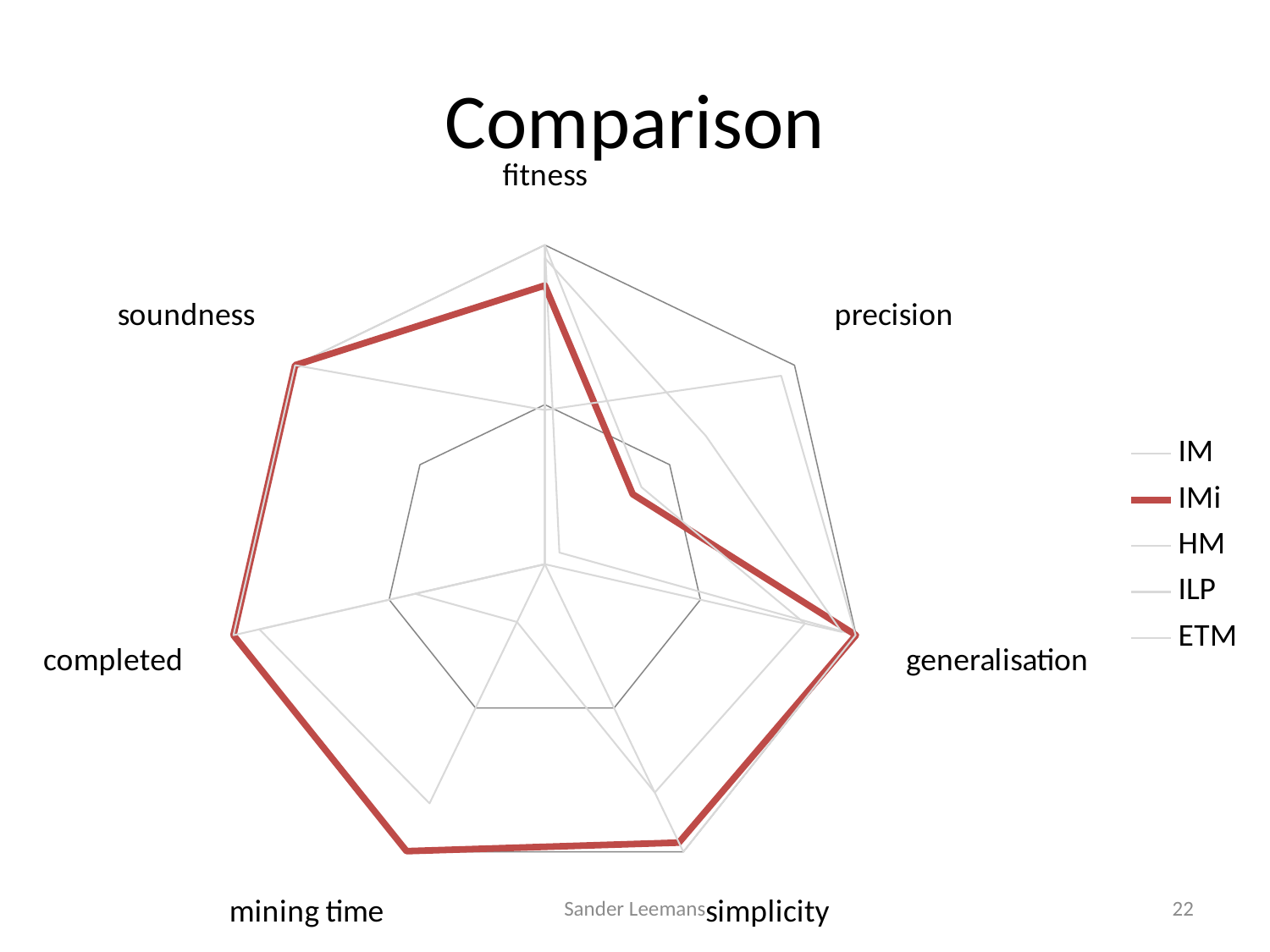
What is the title of the chart? Comparison On which axis does the IMi series have its lowest value? precision For the IMi series, which is larger: the value for fitness or the value for precision? fitness Which series is drawn with the thick red line? IMi How many axes (categories) does the radar chart have? 7 How many series does the legend list? 5 For the IMi series, which is larger: the value for soundness or the value for precision? soundness What kind of chart is shown on the slide? radar chart For the IMi series, which is larger: the value for precision or the value for generalisation? generalisation